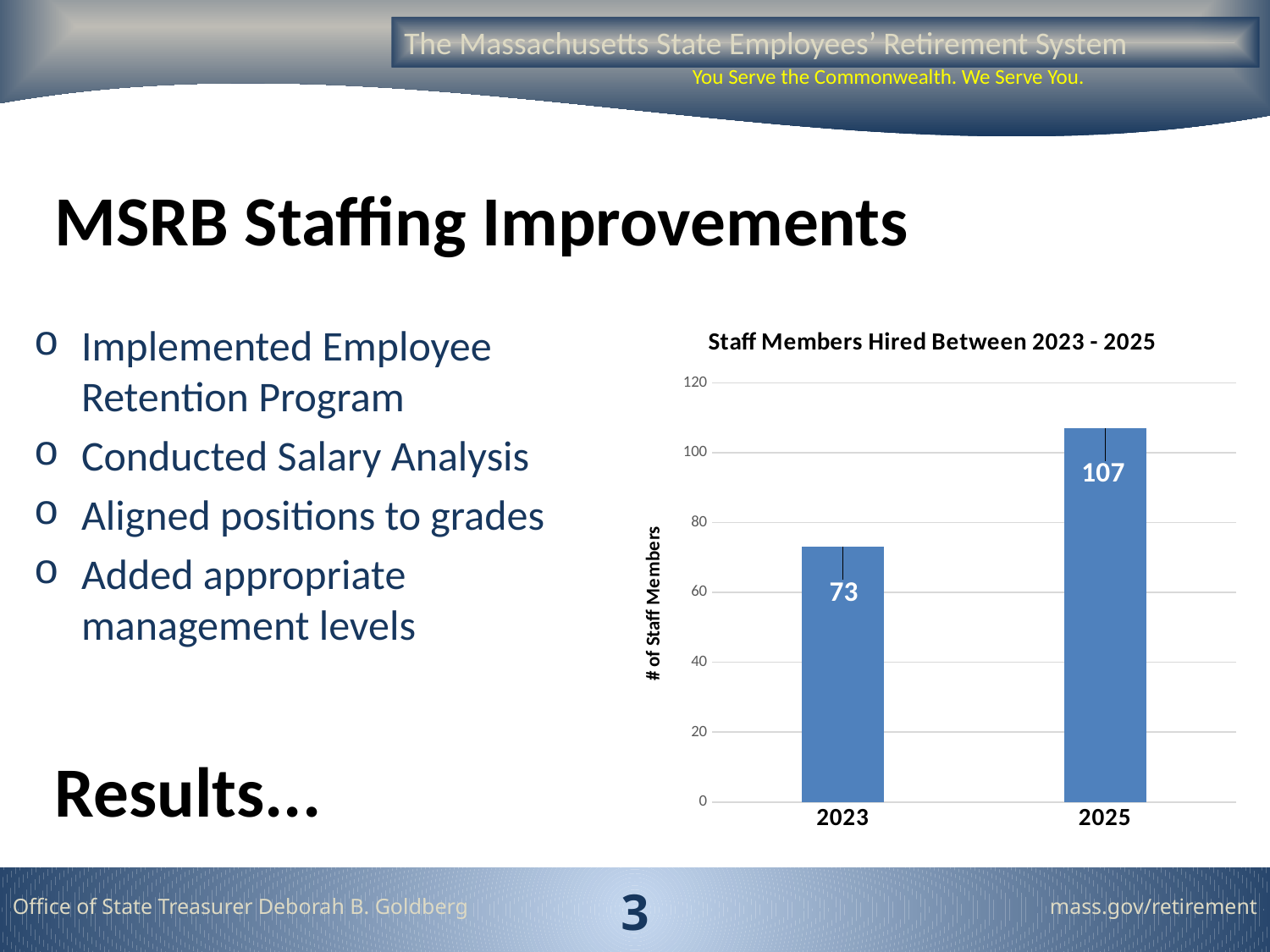
Which is larger, the value for 2023 or the value for 2025? 2025 Is the value for 2025 greater or less than 100? greater Which year has the lowest number of staff members? 2023 How many categories are shown on the x axis of the chart? 2 Is the value for 2023 greater or less than 80? less What kind of chart is shown on the slide? bar chart Do the values rise or fall from 2023 to 2025? rise What is the value for 2023 in the chart? 73 What is the title of the chart? Staff Members Hired Between 2023 - 2025 Which year has the highest number of staff members? 2025 What is the difference between the values for 2025 and 2023? 34 What is the value for 2025 in the chart? 107